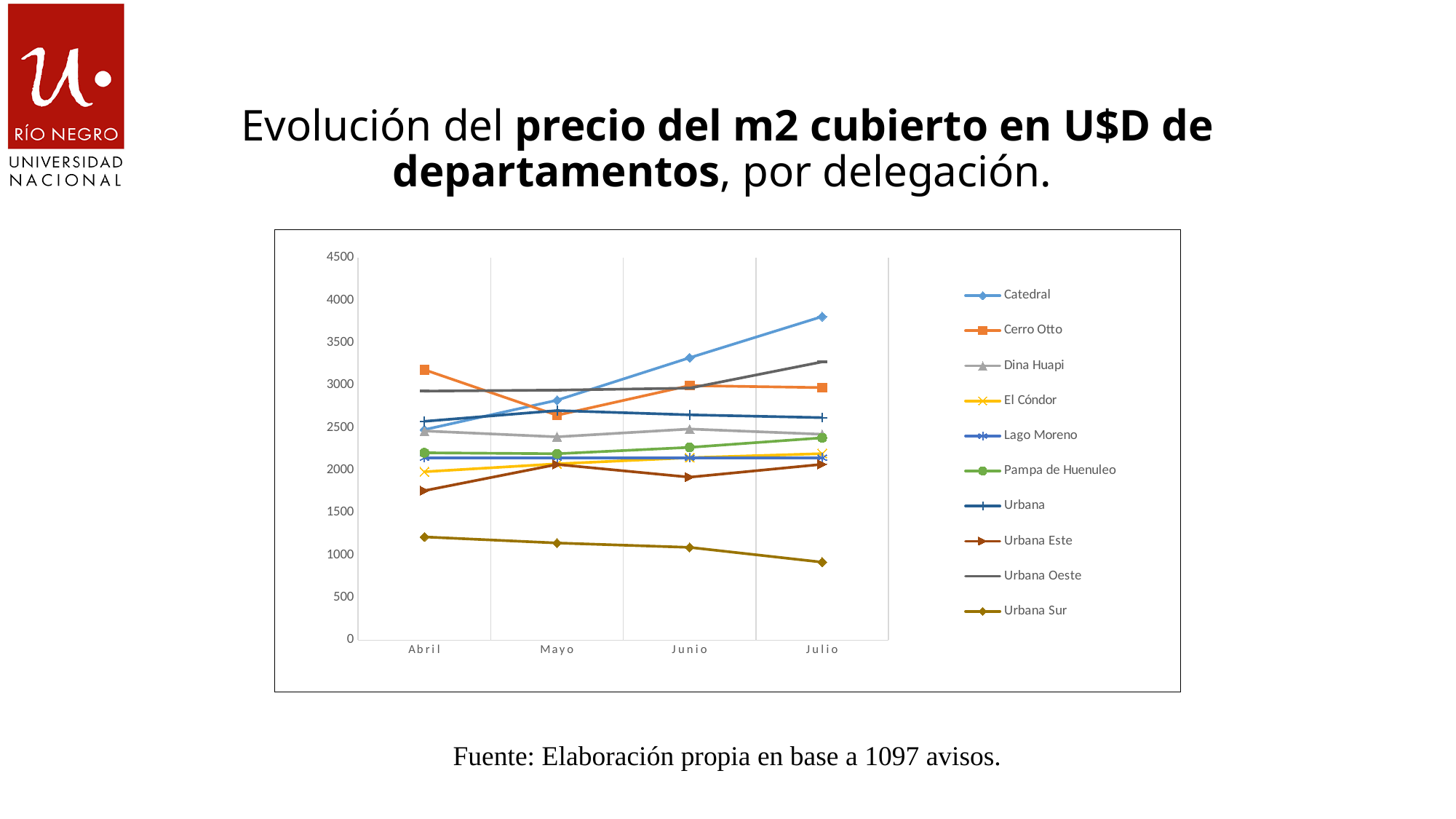
How many months are shown on the x axis? 4 Does the value for Urbana Sur rise or fall from Abril to Julio? fall Does the value for Catedral rise or fall from Abril to Julio? rise Is the value for Urbana Sur in Julio greater or less than 1000? less Which delegación has the lowest value in Julio? Urbana Sur Which delegación has the highest value in Abril? Cerro Otto In Abril, which is larger: the value for Cerro Otto or the value for Catedral? Cerro Otto Is the value for Catedral in Julio greater or less than 3500? greater What kind of chart is shown on the slide? line chart Which delegación has the highest value in Julio? Catedral How many series does the legend list? 10 Which month is the last category on the x axis? Julio